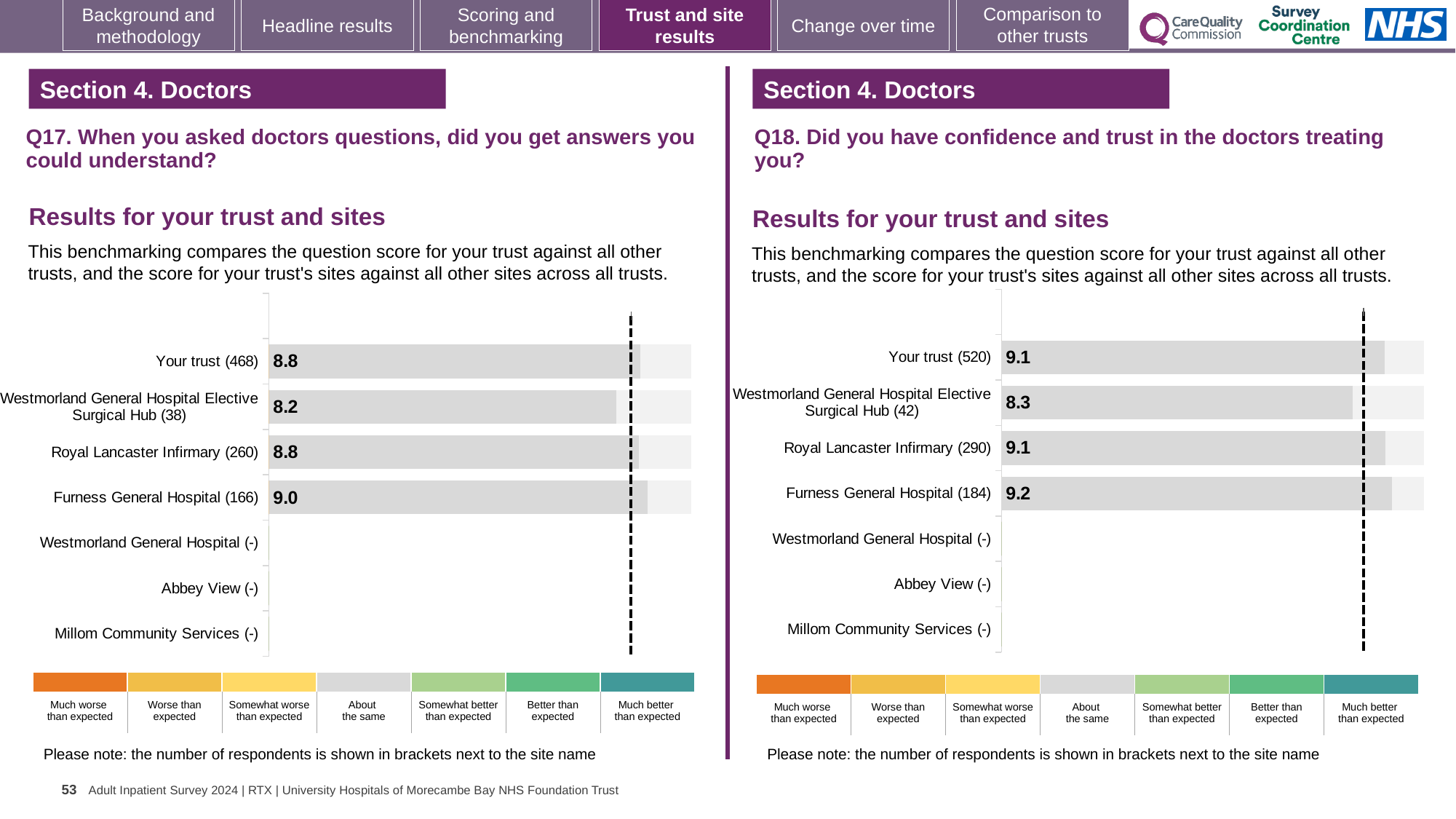
In the Q17 chart on the left, which site has the lowest score? Westmorland General Hospital Elective Surgical Hub In the Q18 chart on the right, what is the score for Furness General Hospital? 9.2 In the Q18 chart on the right, what is the score for Royal Lancaster Infirmary? 9.1 What kind of chart is the Q18 chart on the right? Bar chart In the Q17 chart on the left, what is the difference between the scores for Furness General Hospital and Westmorland General Hospital Elective Surgical Hub? 0.8 In the Q18 chart on the right, which is larger: the score for Furness General Hospital or for Royal Lancaster Infirmary? Furness General Hospital In the Q18 chart on the right, which site has the lowest score? Westmorland General Hospital Elective Surgical Hub In the Q17 chart on the left, what is the score for Your trust? 8.8 In the Q18 chart on the right, what is the difference between the scores for Your trust and Westmorland General Hospital Elective Surgical Hub? 0.8 In the Q17 chart on the left, what is the score for Westmorland General Hospital Elective Surgical Hub? 8.2 In the Q17 chart on the left, which site has the highest score? Furness General Hospital How many categories are listed on the y axis of the Q17 chart on the left? 7